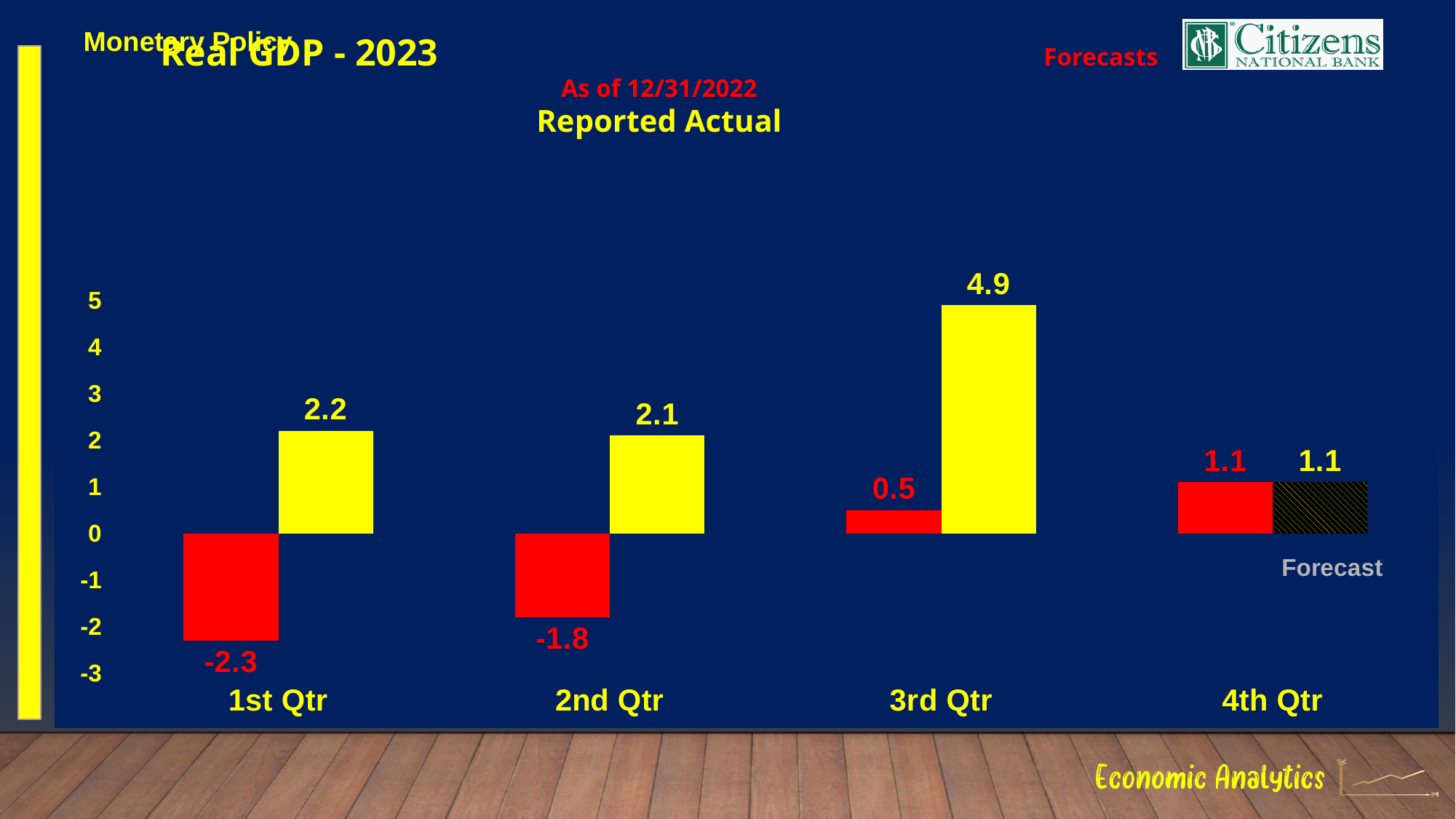
What type of chart is shown on the slide? Bar chart What is the Forecasts value for the 1st Qtr? -2.3 How many quarters are shown on the x axis? 4 Which is larger for the 2nd Qtr, the Forecasts value or the Reported Actual value? Reported Actual What is the Reported Actual value for the 1st Qtr? 2.2 What is the difference between the Reported Actual and Forecasts values for the 3rd Qtr? 4.4 Which quarter has the lowest Forecasts value? 1st Qtr What is the Reported Actual value for the 3rd Qtr? 4.9 What colour are the Forecasts bars? Red What is the Forecasts value for the 2nd Qtr? -1.8 Which quarter has the highest Reported Actual value? 3rd Qtr How many data series does the chart show? 2